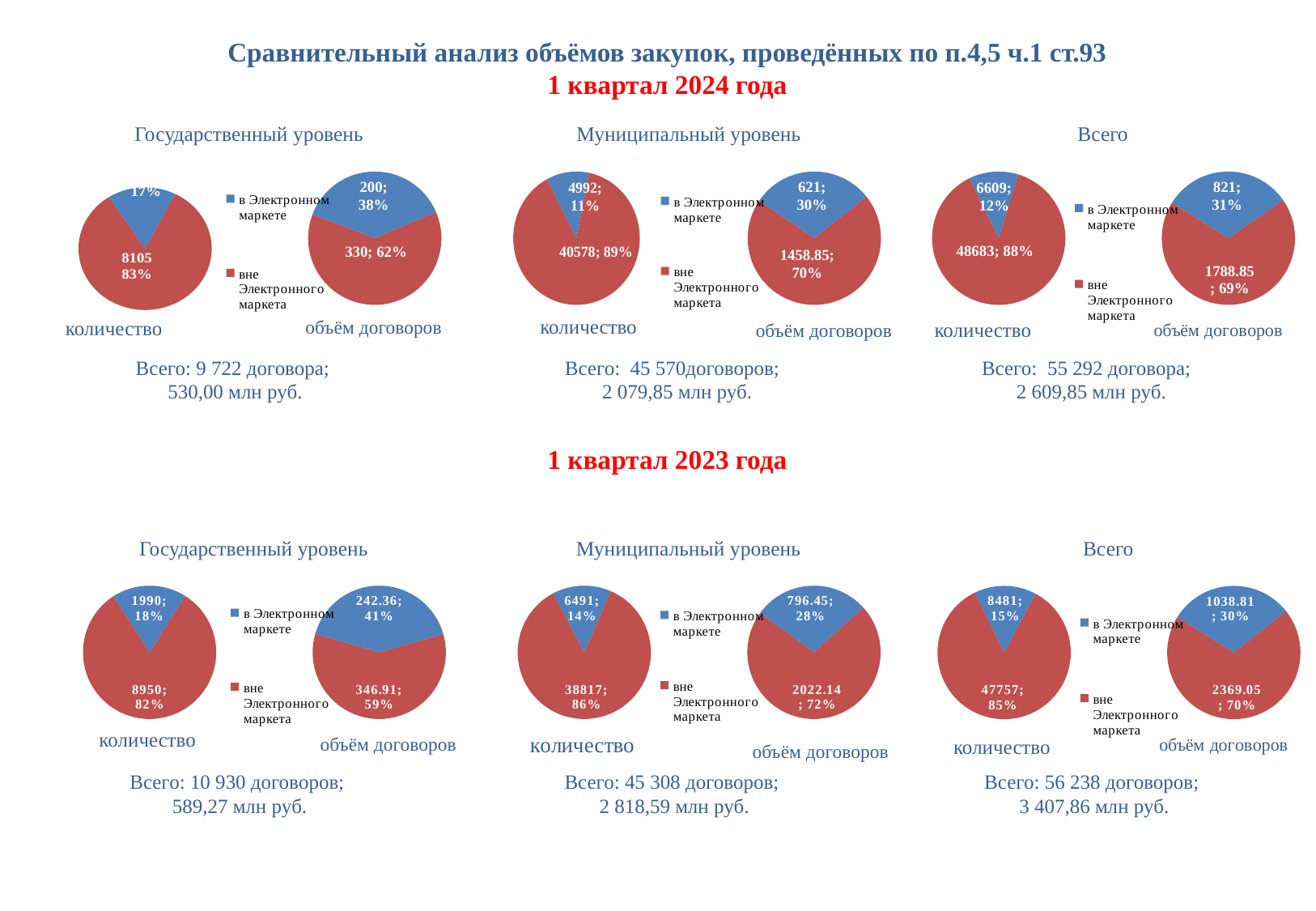
In the 2024 'Всего' 'количество' pie chart, what is the difference between the 'вне Электронного маркета' and 'в Электронном маркете' values? 42074 In the 2024 'Государственный уровень' 'объём договоров' pie chart, what is the value for 'в Электронном маркете'? 200; 38% In the 2023 'Всего' 'количество' pie chart, which slice is larger: 'в Электронном маркете' or 'вне Электронного маркета'? вне Электронного маркета How many slices does the 2024 'Муниципальный уровень' 'объём договоров' pie chart have? 2 How many entries does the legend of the 2023 'Всего' 'объём договоров' pie chart list? 2 In the 2024 'Государственный уровень' 'количество' pie chart, which colour represents 'в Электронном маркете'? blue In the 2024 'Муниципальный уровень' 'количество' pie chart, what is the value for 'вне Электронного маркета'? 40578; 89% In the 2023 'Муниципальный уровень' 'объём договоров' pie chart, what share does 'в Электронном маркете' have? 28% In the 2023 'Государственный уровень' 'объём договоров' pie chart, what is the value for 'вне Электронного маркета'? 346.91; 59% In the 2023 'Государственный уровень' 'количество' pie chart, what is the total of the two slices? 10940 What type of chart is used throughout the slide? pie chart In the 2024 'Всего' 'объём договоров' pie chart, what share does 'вне Электронного маркета' have? 69%